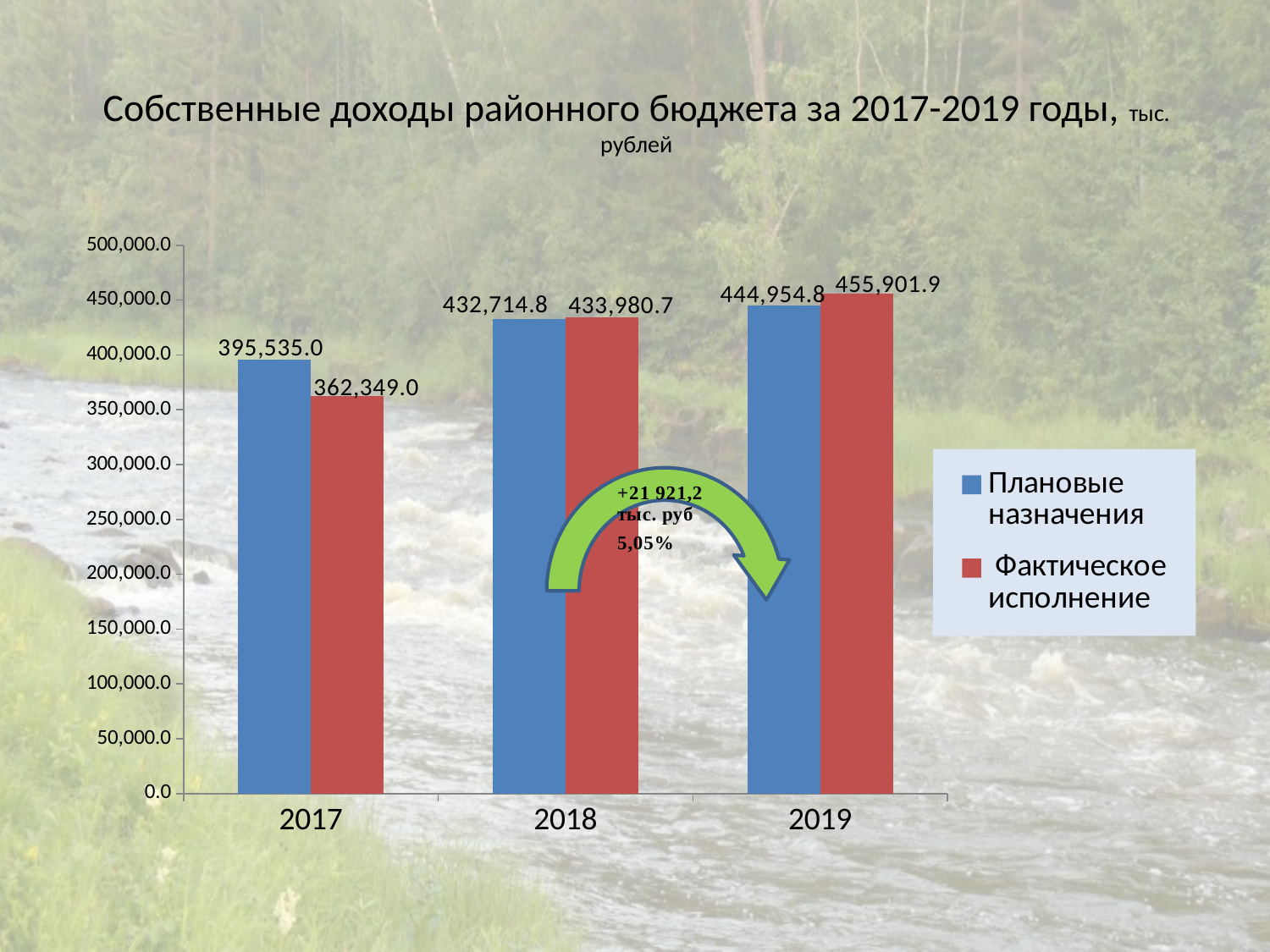
Is the value of Фактическое исполнение for 2017 greater or less than 350,000.0? greater What is the difference between Плановые назначения and Фактическое исполнение in 2017? 33,186.0 Which year has the lowest value for Плановые назначения? 2017 Which year has the highest value for Фактическое исполнение? 2019 What is the value of Плановые назначения for 2017? 395,535.0 How many series does the legend list? 2 What is the value of Фактическое исполнение for 2018? 433,980.7 How many years are shown on the x axis? 3 By how much does Фактическое исполнение in 2019 exceed Фактическое исполнение in 2018? 21,921.2 In 2019, which is larger: Плановые назначения or Фактическое исполнение? Фактическое исполнение Do the values of Плановые назначения rise or fall from 2017 to 2019? rise What is the value of Фактическое исполнение for 2019? 455,901.9